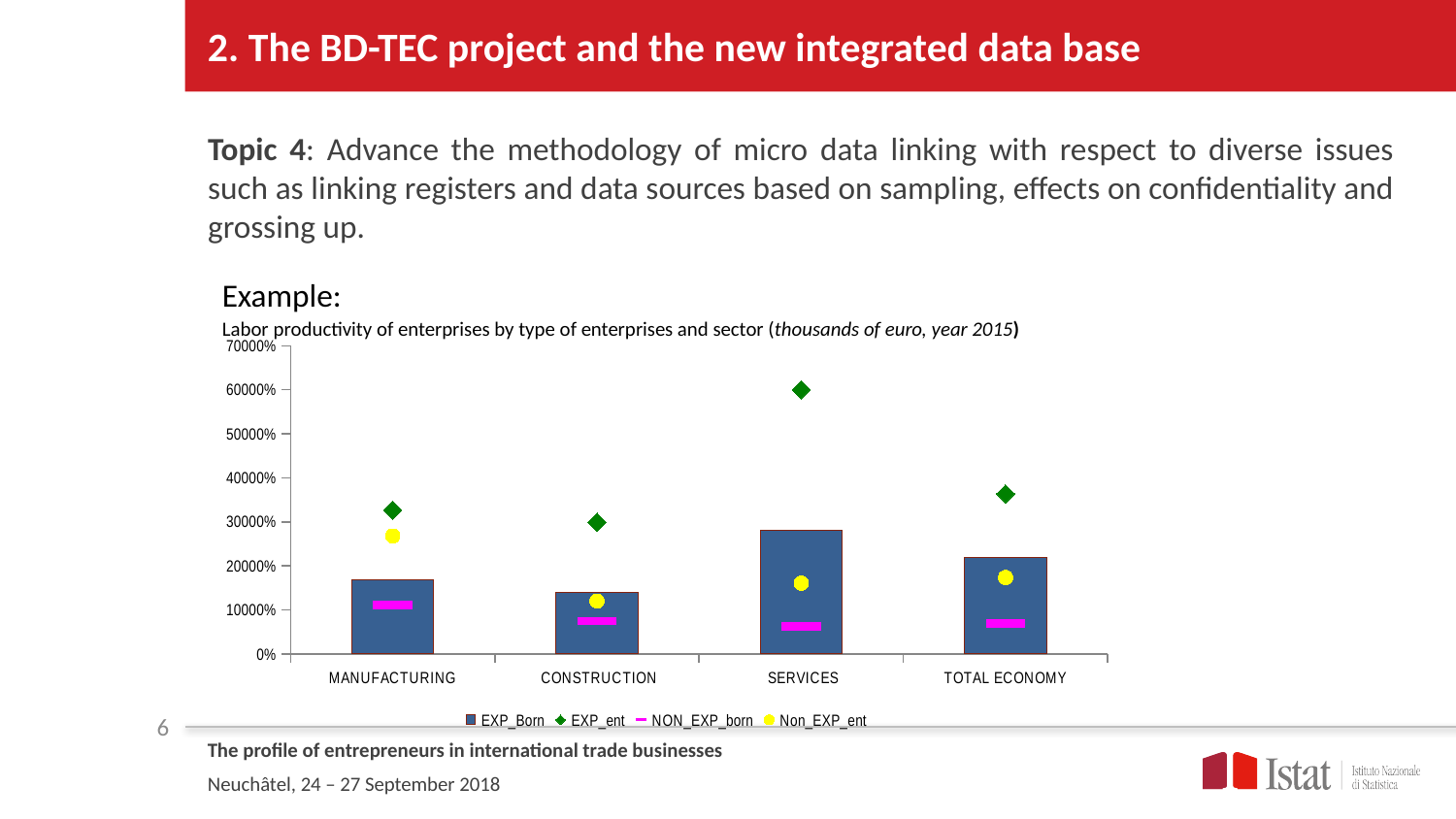
Which sector has the lowest EXP_Born bar? CONSTRUCTION Which is larger, the EXP_Born value for SERVICES or for TOTAL ECONOMY? SERVICES What is the title of the chart? Labor productivity of enterprises by type of enterprises and sector (thousands of euro, year 2015) Is the EXP_Born value for SERVICES greater or less than 20000%? greater How many sectors (categories) are shown on the x axis of the chart? 4 Which sector has the highest Non_EXP_ent value (yellow circle)? MANUFACTURING Which sector has the highest EXP_Born bar? SERVICES Which series in the chart is drawn as bars? EXP_Born Which sector has the highest EXP_ent value (green diamond)? SERVICES Is the EXP_ent value for SERVICES greater or less than 50000%? greater Is the EXP_Born value for MANUFACTURING greater or less than 20000%? less How many series does the chart's legend list? 4